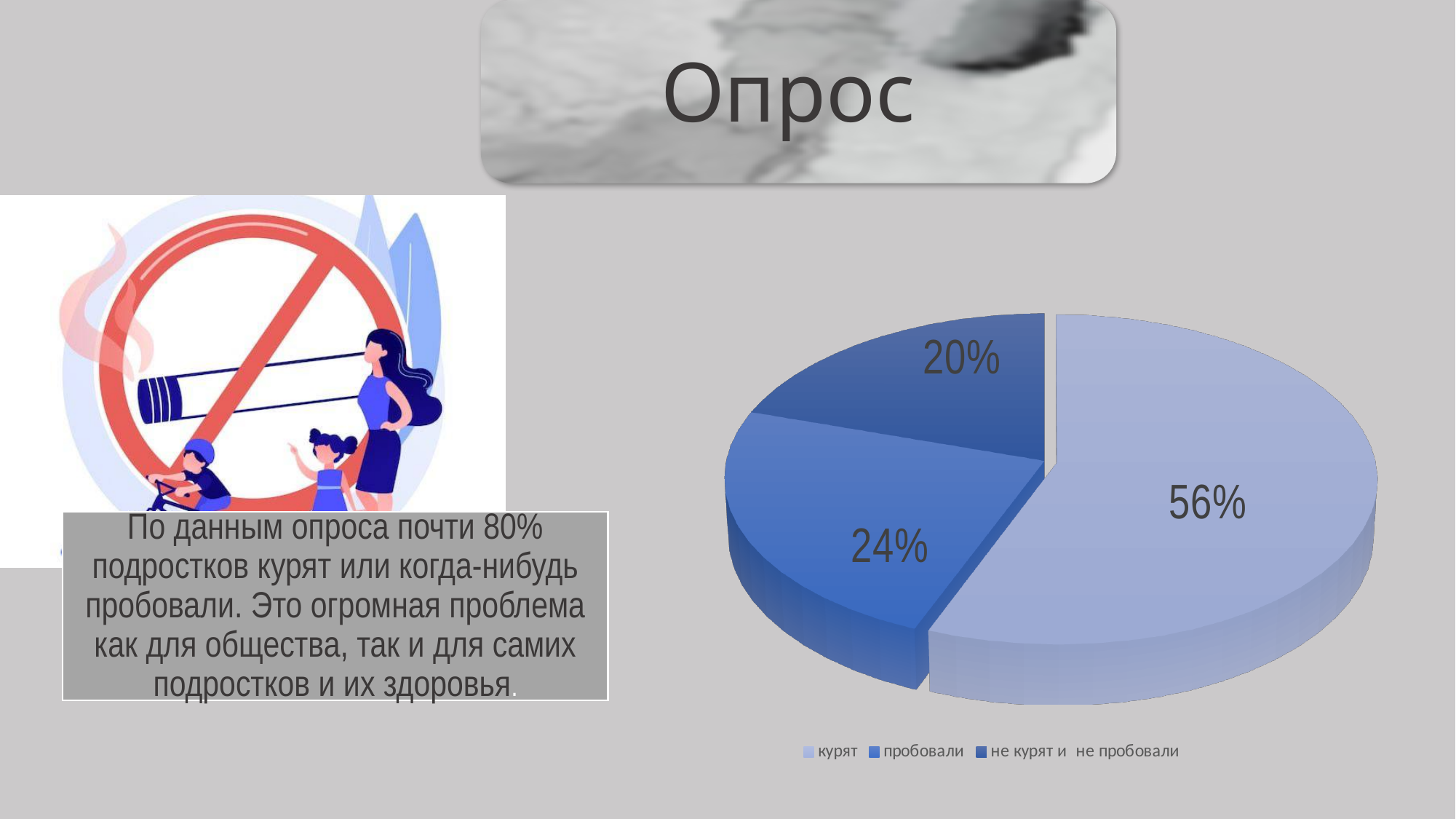
What is the combined share of the "курят" and "пробовали" slices? 80% Which category has the largest slice of the pie? курят What percentage of the pie is labelled for the category "курят"? 56% What percentage of the pie is labelled for the category "пробовали"? 24% What percentage of the pie is labelled for the category "не курят и не пробовали"? 20% What kind of chart is shown on the slide? pie chart How many slices does the pie chart have? 3 What is the difference in percentage points between the "курят" slice and the "пробовали" slice? 32 How many entries does the chart legend list? 3 What is the title shown at the top of the slide above the chart? Опрос Which category has the smallest slice of the pie? не курят и не пробовали Which slice is larger, "пробовали" or "не курят и не пробовали"? пробовали